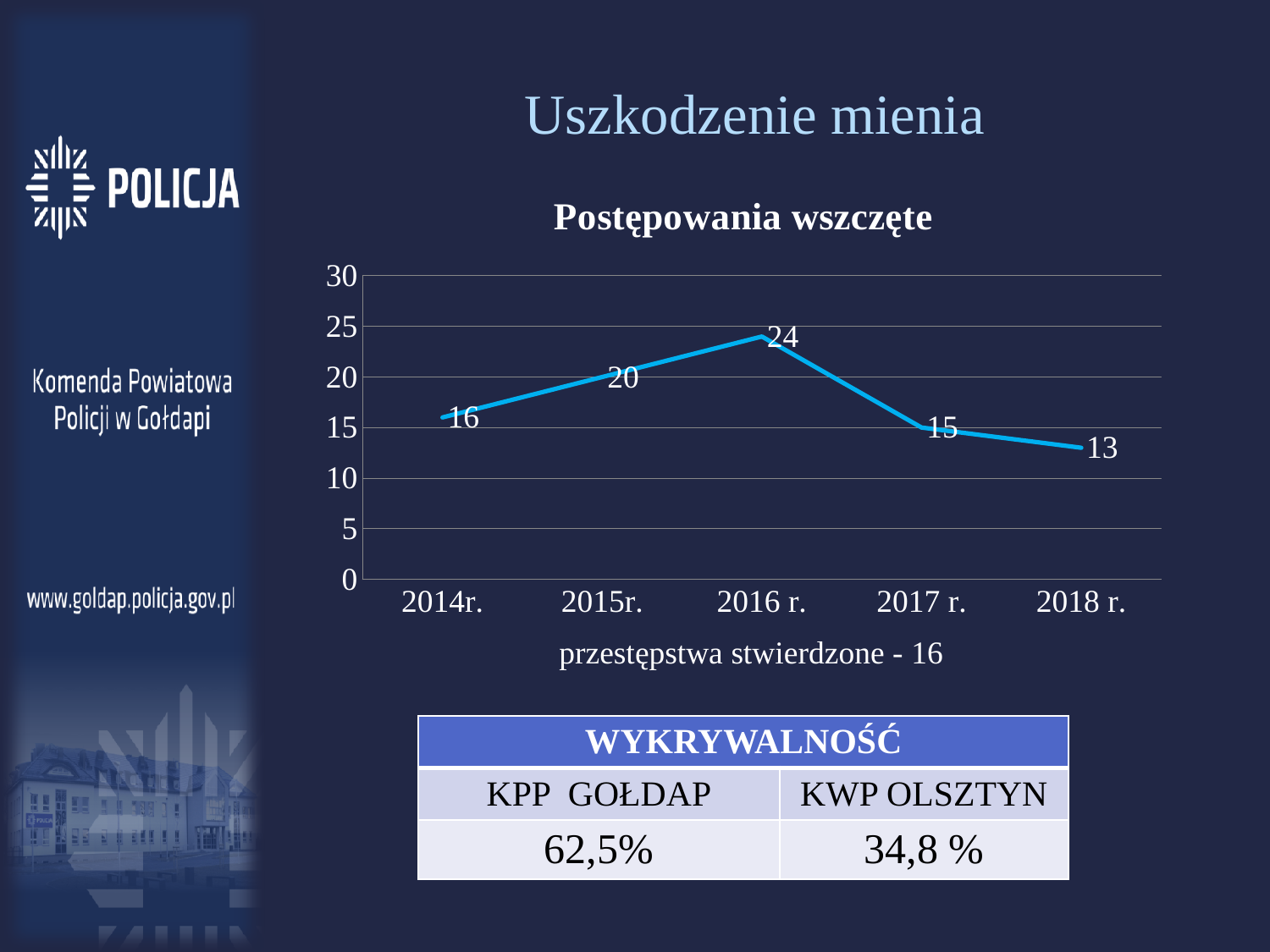
Which year has the highest value in the Postępowania wszczęte chart? 2016 r. What is the difference between the values for 2016 r. and 2017 r. in the Postępowania wszczęte chart? 9 Which year has the lowest value in the Postępowania wszczęte chart? 2018 r. How many years are plotted in the Postępowania wszczęte chart? 5 Is the value for 2016 r. in the Postępowania wszczęte chart greater or less than 20? greater What is the value for 2018 r. in the Postępowania wszczęte chart? 13 Do the values in the Postępowania wszczęte chart rise or fall from 2016 r. to 2018 r.? fall Which is larger in the Postępowania wszczęte chart, the value for 2015r. or the value for 2017 r.? 2015r. What is the value for 2016 r. in the Postępowania wszczęte chart? 24 What is the title of the chart on the slide? Postępowania wszczęte What is the value for 2014r. in the Postępowania wszczęte chart? 16 What kind of chart is the Postępowania wszczęte chart? line chart